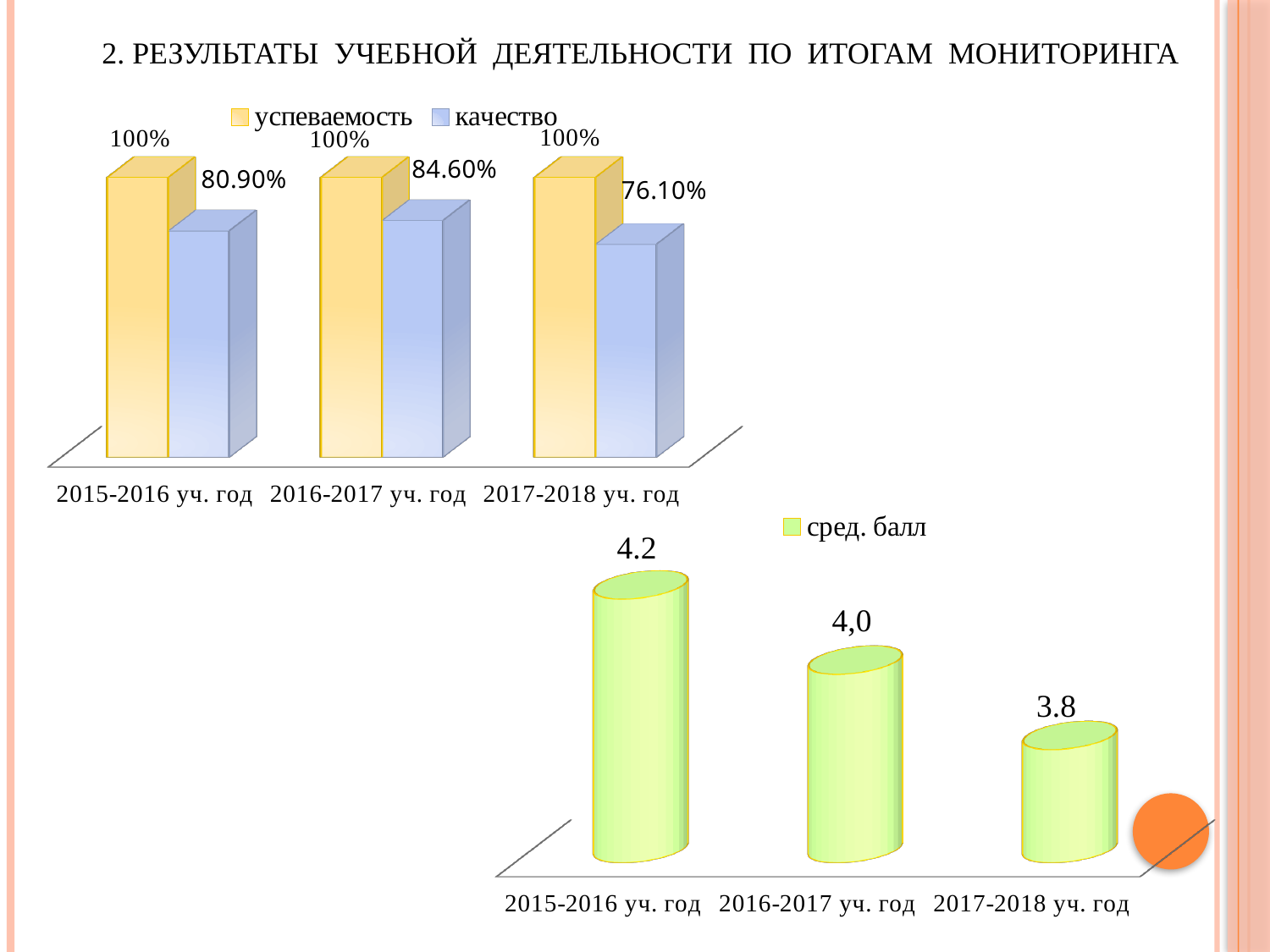
How many year categories are shown in the top-left chart? 3 In the top-left chart, is качество higher in 2015-2016 уч. год or in 2017-2018 уч. год? 2015-2016 уч. год In the bottom-right chart, does сред. балл rise or fall from 2015-2016 уч. год to 2017-2018 уч. год? fall In the bottom-right chart, which year has the highest сред. балл? 2015-2016 уч. год What type of chart is the bottom-right chart? bar chart In the top-left chart, what is the difference between качество in 2016-2017 уч. год and 2017-2018 уч. год? 8.50% In the top-left chart, which year has the highest качество value? 2016-2017 уч. год In the top-left chart, which year has the lowest качество value? 2017-2018 уч. год In the top-left chart, what is the value of успеваемость for 2017-2018 уч. год? 100% In the bottom-right chart, what is the сред. балл for 2016-2017 уч. год? 4,0 In the top-left chart, what is the value of качество for 2016-2017 уч. год? 84.60% How many series does the legend of the top-left chart list? 2